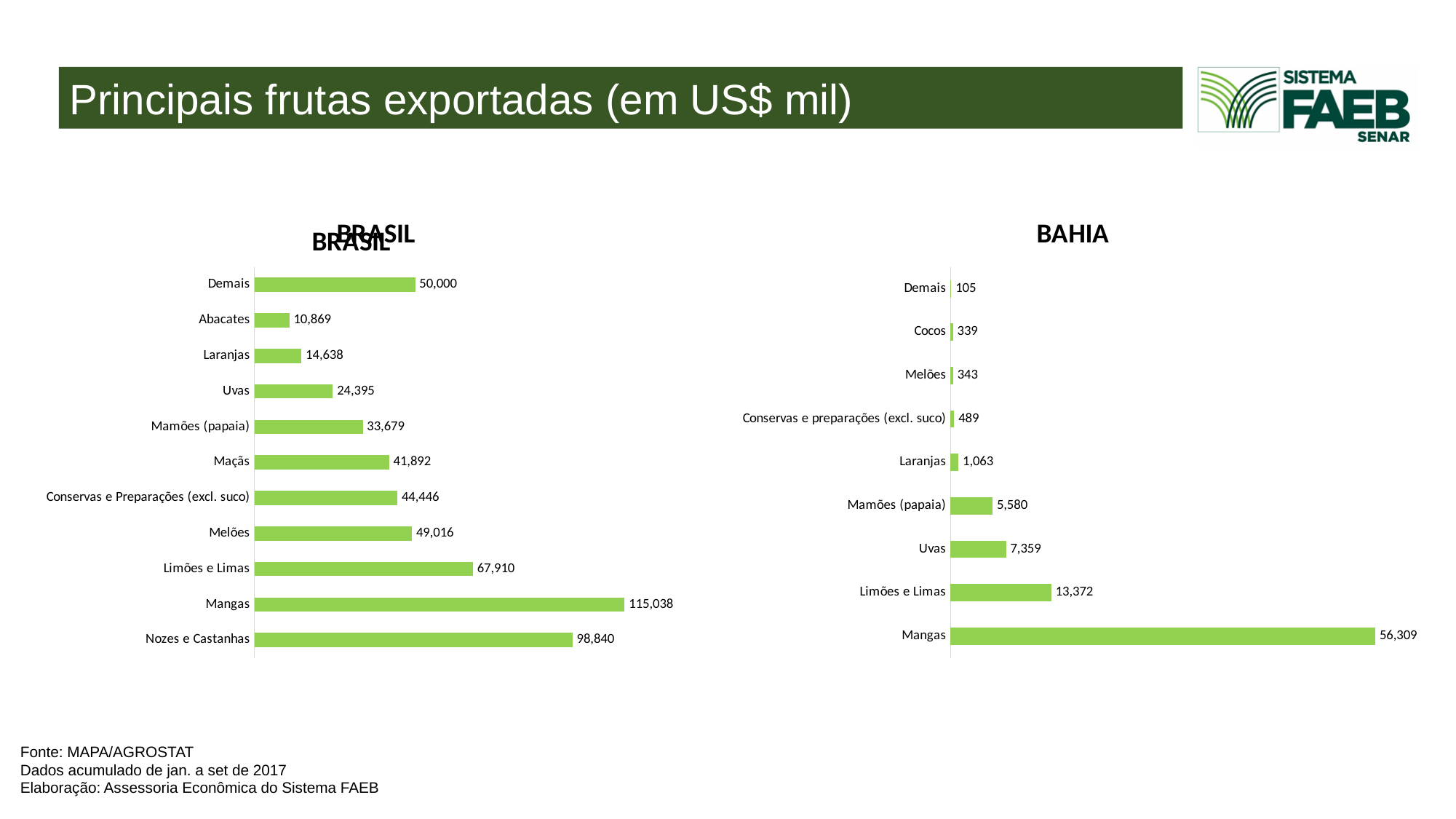
What kind of chart is the BAHIA chart? Bar chart In the BAHIA chart, which category has the lowest value? Demais In the BRASIL chart, what is the difference between Mangas and Nozes e Castanhas? 16,198 In the BRASIL chart, what is the value for Mangas? 115,038 In the BRASIL chart, what is the value for Conservas e Preparações (excl. suco)? 44,446 In the BRASIL chart, which is larger: Melões or Maçãs? Melões In the BAHIA chart, what is the value for Uvas? 7,359 How many categories are shown in the BAHIA chart? 9 In the BRASIL chart, which category has the lowest value? Abacates In the BAHIA chart, which category has the highest value? Mangas In the BAHIA chart, what is the difference between Mangas and Limões e Limas? 42,937 How many categories are shown in the BRASIL chart? 11